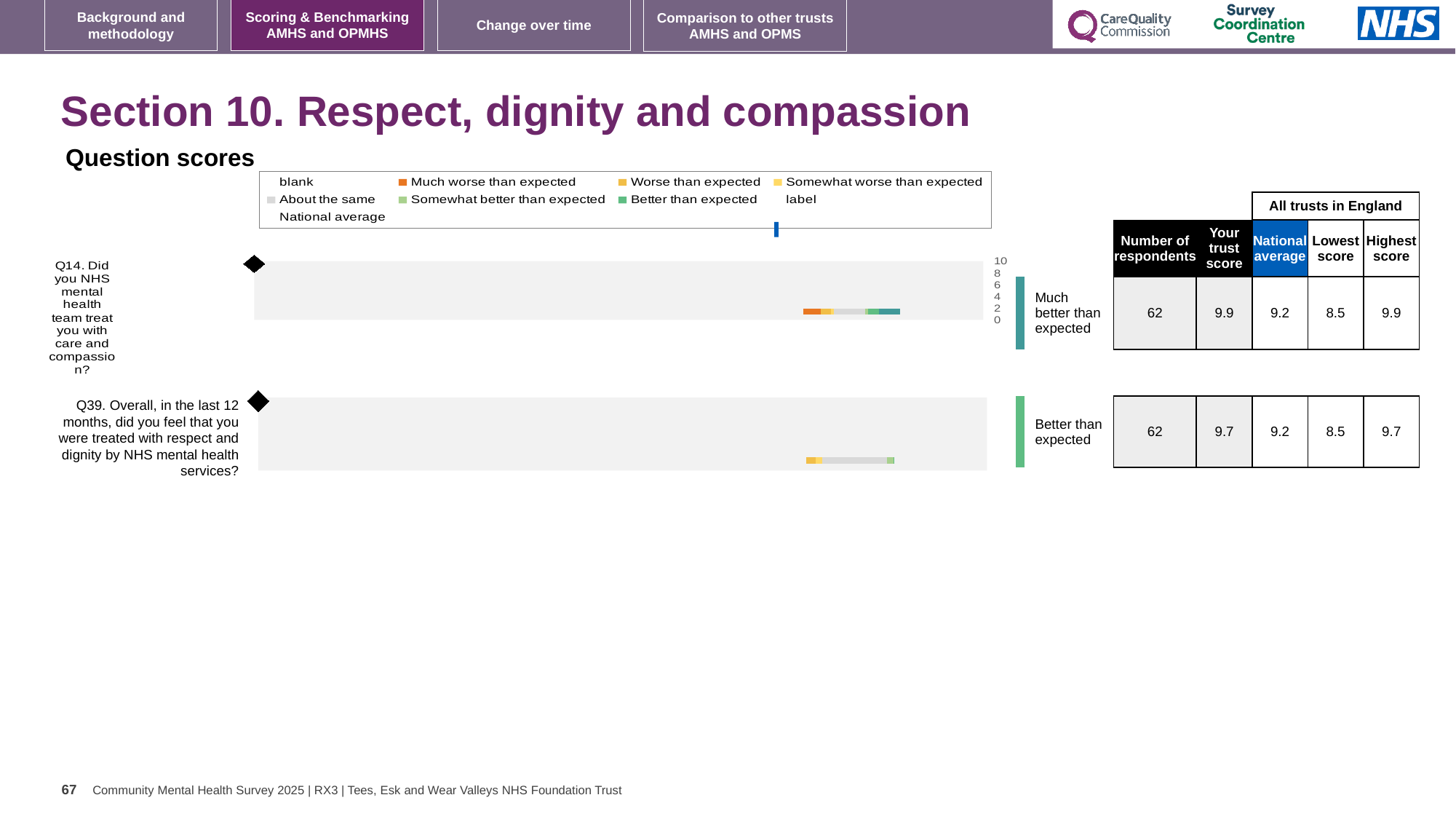
What is the lowest score among all trusts in England for Q14? 8.5 Which benchmark category is shown for Q14? Much better than expected What kind of chart is used to show the question scores on this slide? bar chart Which question has the higher trust score, Q14 or Q39? Q14 Which benchmark category is shown for Q39? Better than expected What is the trust score for Q14 (care and compassion)? 9.9 What is the highest score among all trusts in England for Q39? 9.7 What is the national average for Q14? 9.2 How many respondents answered Q14? 62 How many questions are charted in the Question scores section? 2 By how much does the trust score for Q14 exceed the national average for Q14? 0.7 What is the trust score for Q39 (respect and dignity)? 9.7